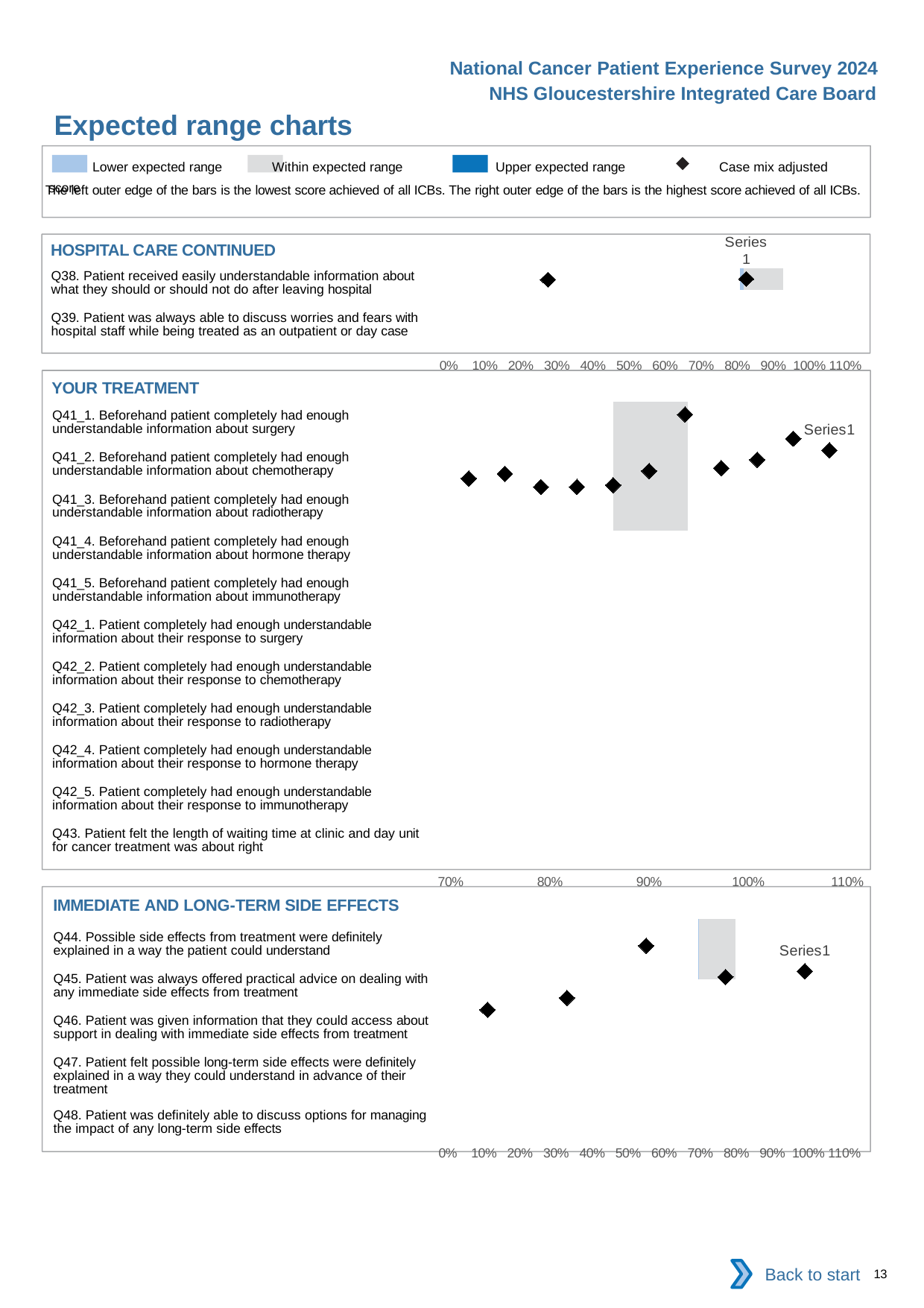
In the IMMEDIATE AND LONG-TERM SIDE EFFECTS chart, is the leftmost plotted diamond greater or less than 50%? less In the YOUR TREATMENT chart, is the rightmost plotted diamond greater or less than 100%? greater What marker symbol represents the case mix adjusted score in the charts? A diamond In the YOUR TREATMENT chart, is the leftmost plotted diamond greater or less than 80%? less How many questions are listed in the YOUR TREATMENT chart? 11 What colour is used for the 'Within expected range' band in the legend? Grey In the YOUR TREATMENT chart, what is the lowest value shown on the horizontal axis? 70% How many questions are listed in the HOSPITAL CARE CONTINUED chart? 2 How many questions are listed in the IMMEDIATE AND LONG-TERM SIDE EFFECTS chart? 5 How many legend entries are shown in the key at the top of the Expected range charts slide? 4 In the IMMEDIATE AND LONG-TERM SIDE EFFECTS chart, what is the highest value shown on the horizontal axis? 110%